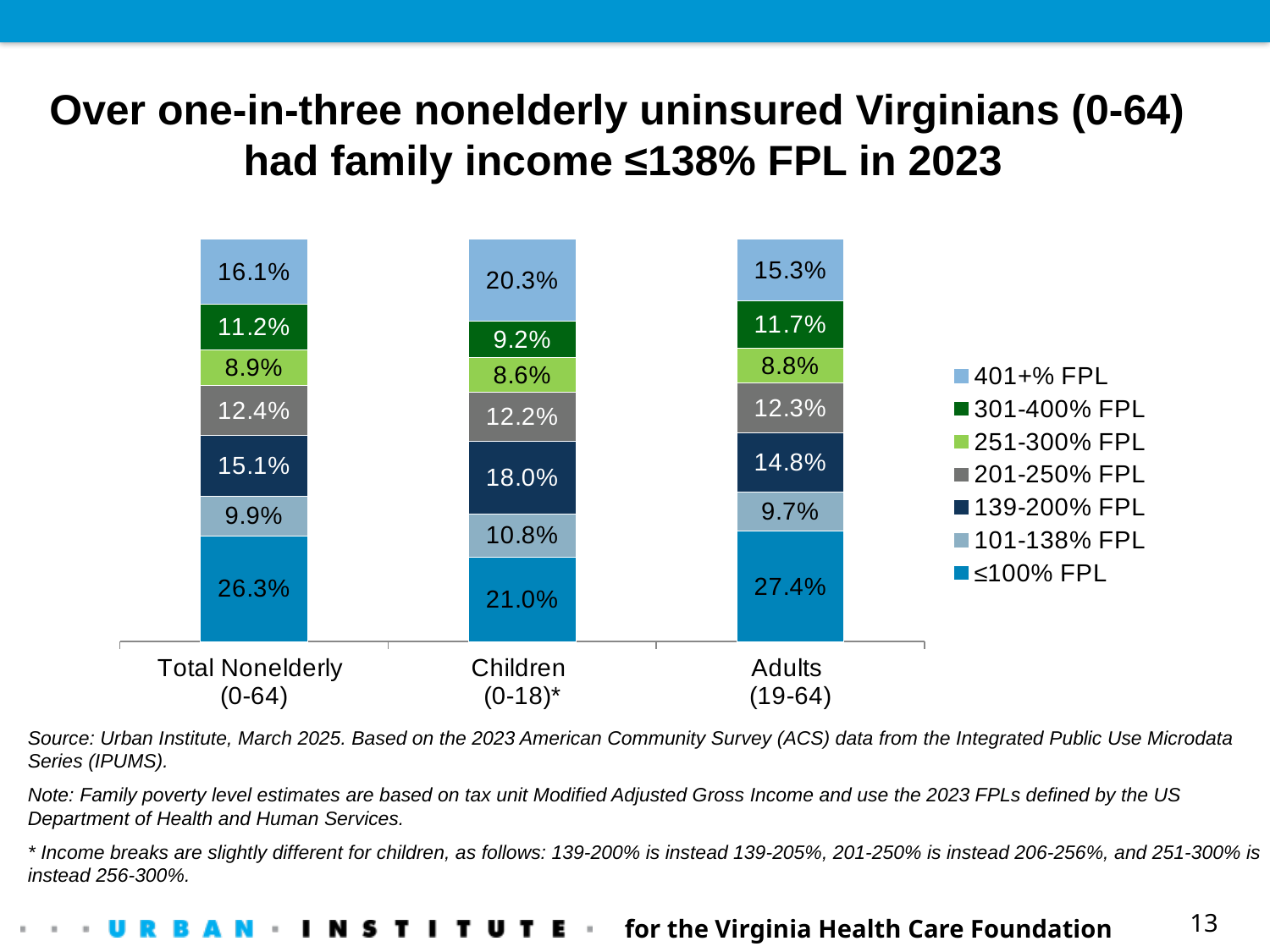
What is the combined share of Total Nonelderly (0-64) with income ≤138% FPL (the ≤100% and 101-138% segments)? 36.2% Which category has the highest ≤100% FPL share? Adults (19-64) How many series does the legend list? 7 What share of Total Nonelderly (0-64) falls in the 139-200% FPL group? 15.1% What kind of chart is shown on the slide? Stacked bar chart Which category has the lowest 139-200% FPL share? Adults (19-64) What percentage of Adults (19-64) had family income ≤100% FPL? 27.4% What is the difference between the ≤100% FPL shares for Adults (19-64) and Children (0-18)*? 6.4 percentage points Which is larger: the 401+% FPL share for Children (0-18)* or for Adults (19-64)? Children (0-18)* What is the 201-250% FPL value for Adults (19-64)? 12.3% What is the value of the 401+% FPL segment for Children (0-18)*? 20.3% How many categories are shown on the x axis? 3